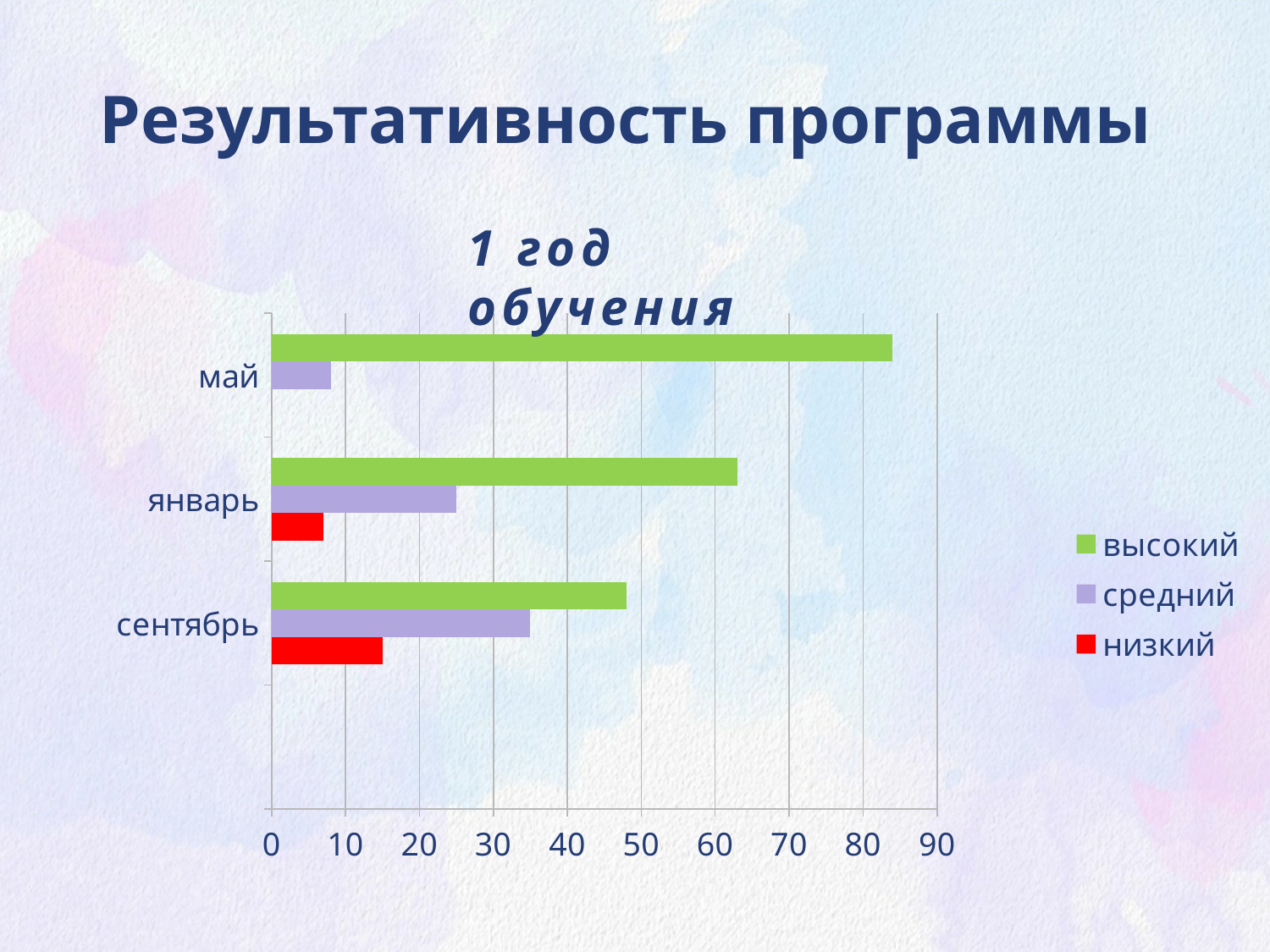
Is the value for высокий in сентябрь greater or less than 40? greater Which category has the highest value for the высокий series? май Which is larger: the средний value in сентябрь or the средний value in май? сентябрь Which is larger in сентябрь: the высокий value or the средний value? высокий Is the value for высокий in май greater or less than 80? greater What kind of chart is shown on the slide? bar chart Which category has the lowest value for the высокий series? сентябрь How many categories are shown on the vertical axis? 3 How many series does the legend list? 3 Which category has the highest value for the низкий series? сентябрь Is the value for средний in январь greater or less than 30? less What is the title of the chart? 1 год обучения